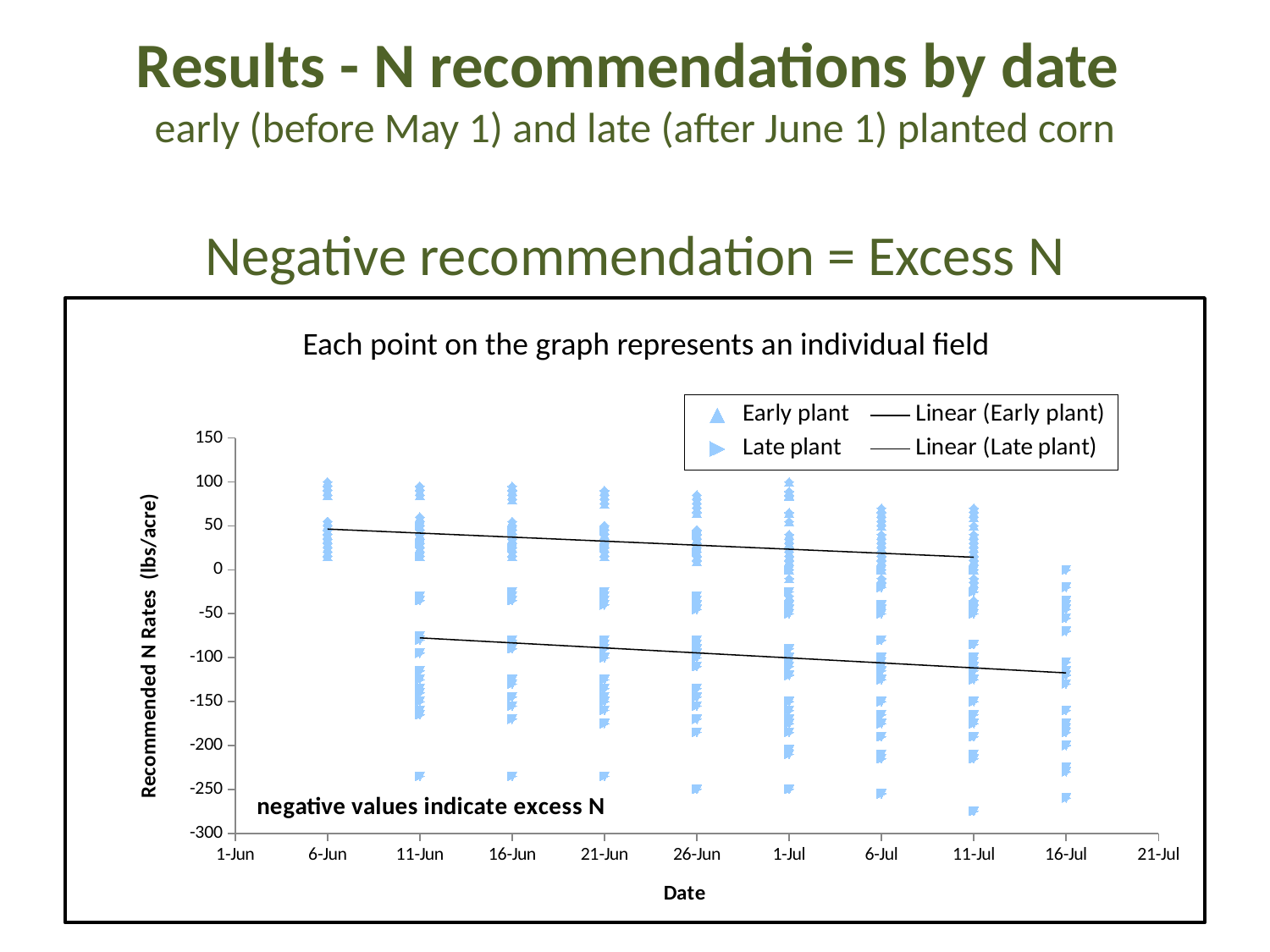
Is the value of the Linear (Early plant) trendline at 6-Jun greater or less than 0? greater What is the lowest value shown on the chart's vertical axis? -300 What kind of chart is shown on the slide? scatter chart Which trendline sits higher on the chart, Linear (Early plant) or Linear (Late plant)? Linear (Early plant) Does the Linear (Early plant) trendline rise or fall from 6-Jun to 11-Jul? fall How many entries does the chart legend list? 4 What is the title of the chart's vertical axis? Recommended N Rates (lbs/acre) What is the highest value shown on the chart's vertical axis? 150 Is the value of the Linear (Late plant) trendline at 16-Jul greater or less than -50? less Which two data series are plotted as points in the chart? Early plant and Late plant Is the value of the Linear (Late plant) trendline at 11-Jun greater or less than -50? less Does the Linear (Late plant) trendline rise or fall from 11-Jun to 16-Jul? fall